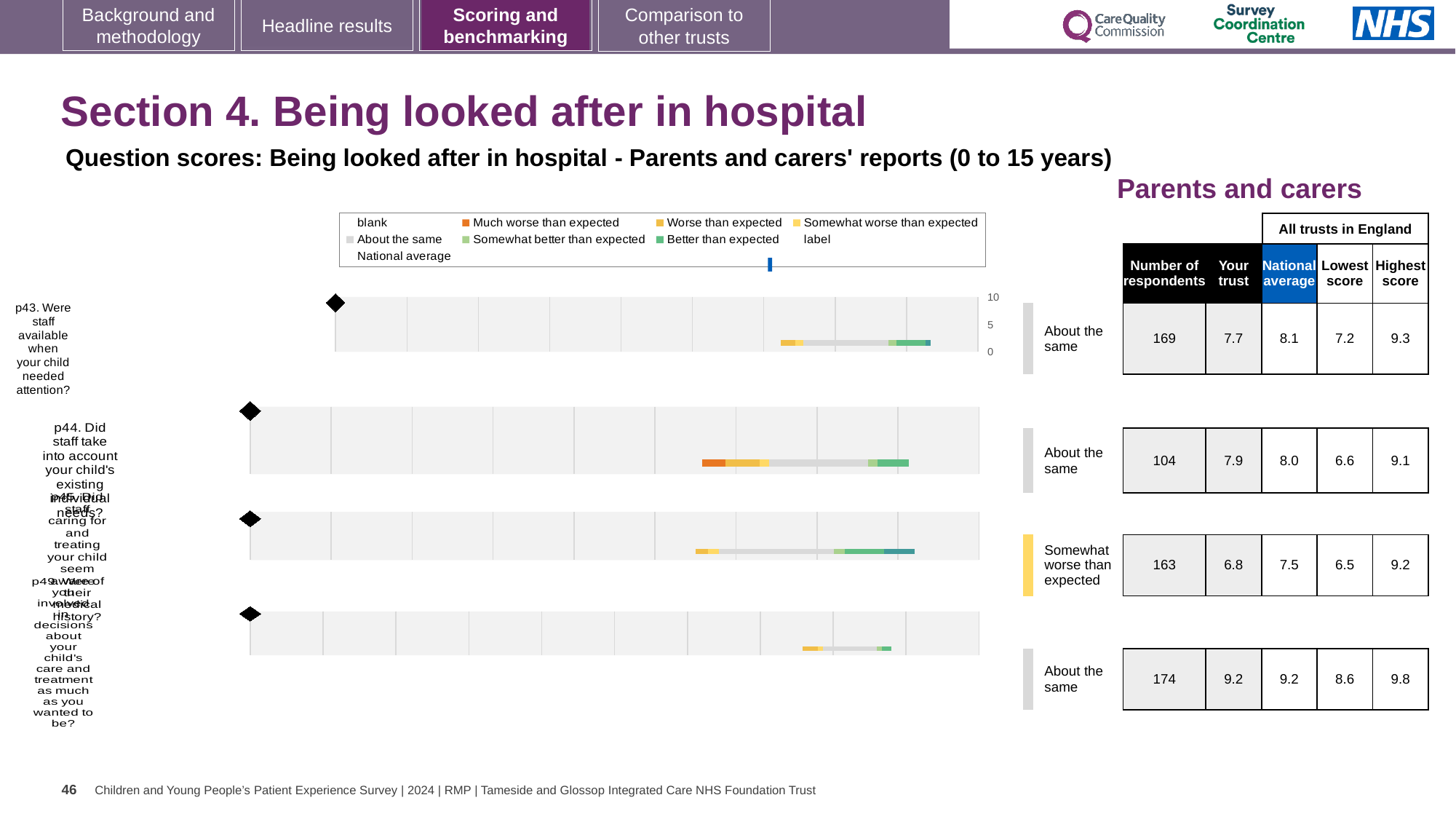
For p43, how much higher is the national average than the 'Your trust' score? 0.4 What is the 'Your trust' score for p43 (Were staff available when your child needed attention?)? 7.7 What is the national average for p44 (Did staff take into account your child's existing individual needs?)? 8.0 Which question row has the highest 'Your trust' score? p49 (bottom row), 9.2 What is the highest score across all trusts in England for the bottom question row (p49)? 9.8 What is the 'Your trust' score for the third question row (p45)? 6.8 What kind of chart is used to show the question scores on this slide? bar chart How many respondents are listed for p43 (Were staff available when your child needed attention?)? 169 Which question row has the lowest 'Your trust' score? p45 (third row), 6.8 Which benchmark category is shown for the third question row (p45)? Somewhat worse than expected For p44, which is larger: the 'Your trust' score or the national average? National average How many question rows (bars) are shown in the benchmark chart? 4